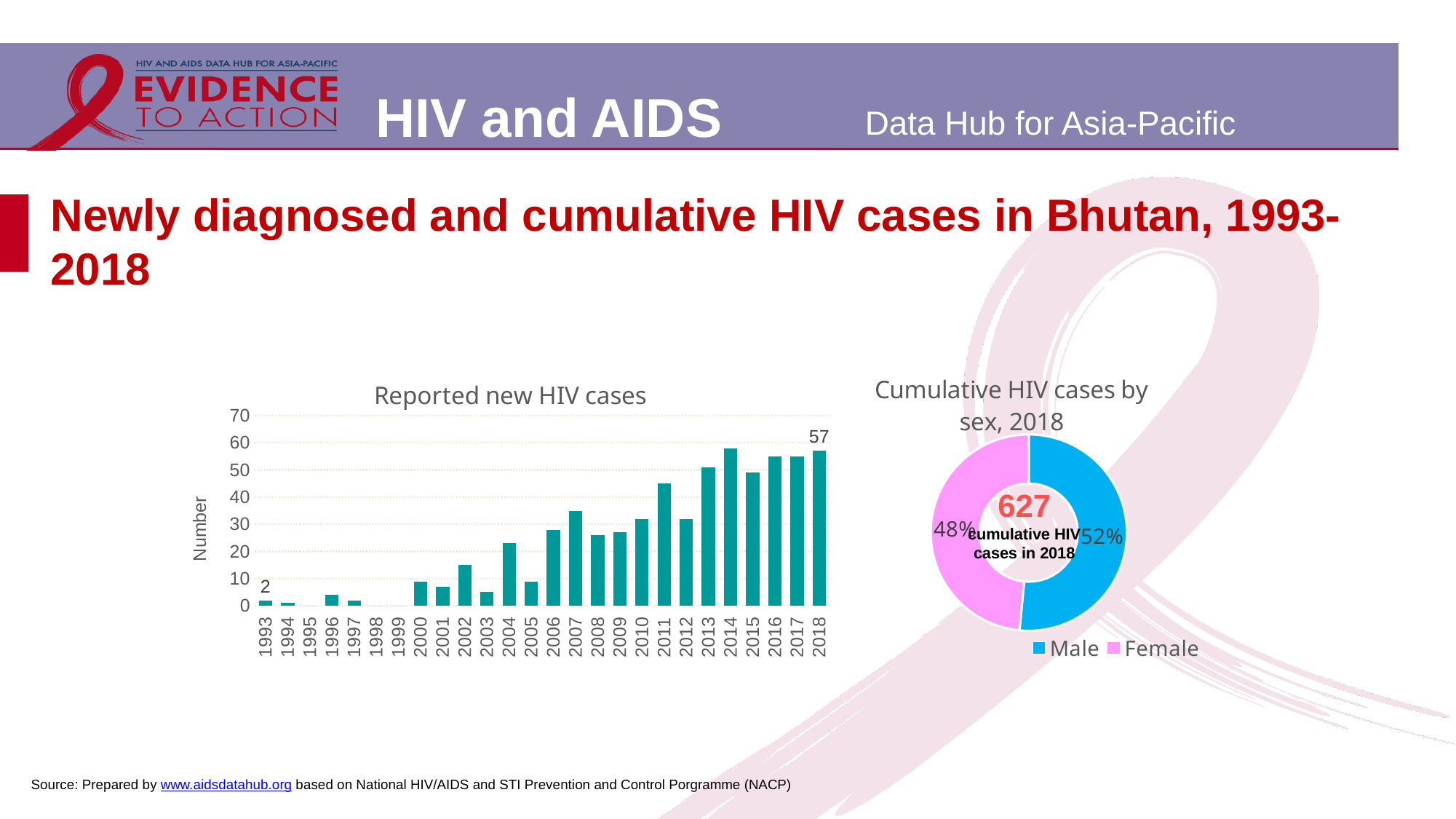
In the 'Reported new HIV cases' chart, is the value for 2011 greater or less than 40? greater In the 'Reported new HIV cases' chart, what is the value for 2018? 57 In the 'Reported new HIV cases' chart, what is the value for 1993? 2 In the 'Reported new HIV cases' chart, is the value for 2008 greater or less than 30? less In the 'Cumulative HIV cases by sex, 2018' chart, what is the total number of cumulative HIV cases shown in the centre? 627 In the 'Reported new HIV cases' chart, how many years are shown on the x axis? 26 In the 'Reported new HIV cases' chart, is the value for 2002 greater or less than 20? less In the 'Reported new HIV cases' chart, do the values generally rise or fall from 1993 to 2018? Rise In the 'Cumulative HIV cases by sex, 2018' chart, which is larger, Male or Female? Male What kind of chart is 'Reported new HIV cases'? Bar chart In the 'Reported new HIV cases' chart, what is the difference between the values for 2018 and 1993? 55 In the 'Cumulative HIV cases by sex, 2018' chart, what share is Male? 52%